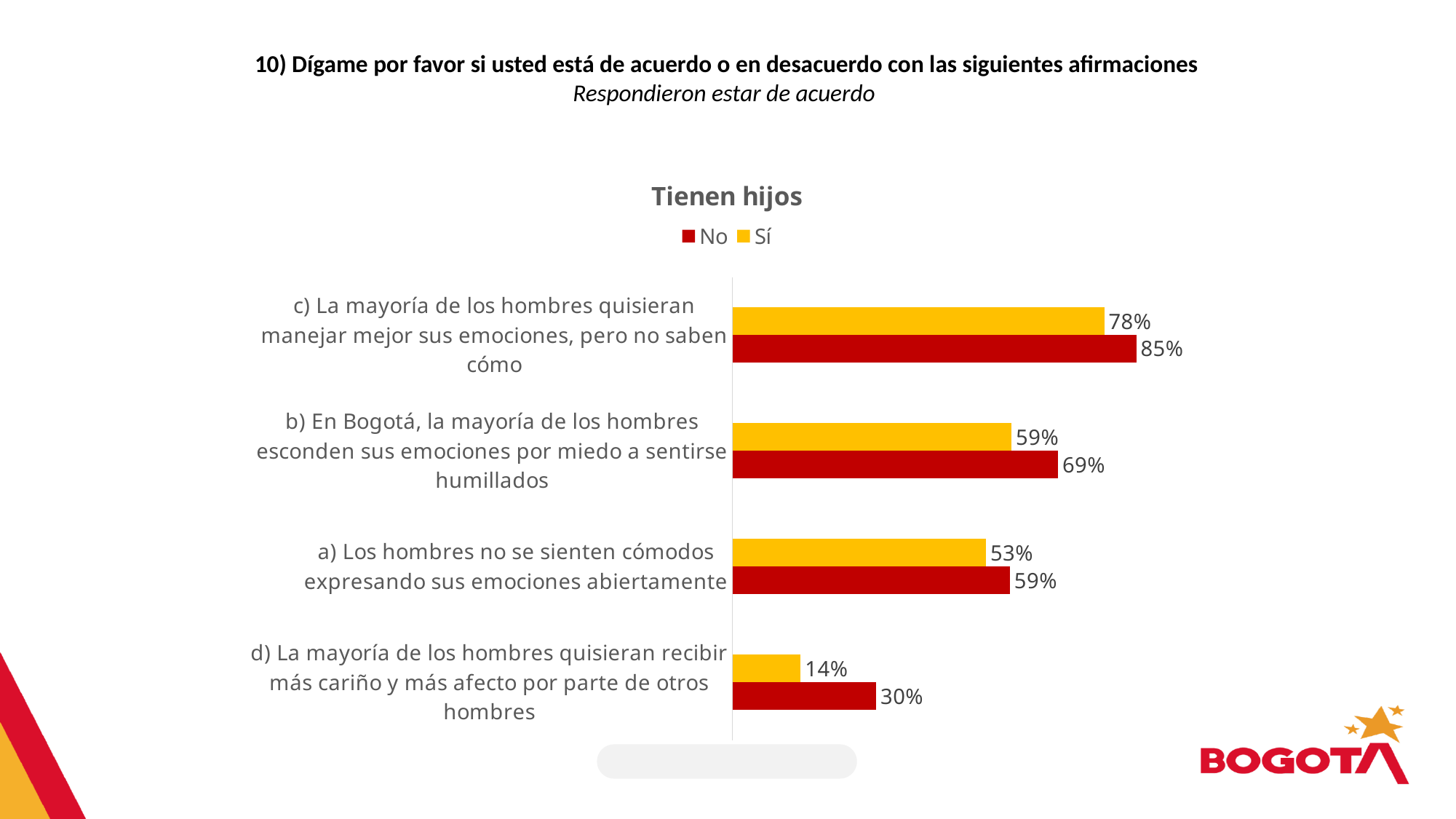
Which statement has the lowest value in the "Sí" series? d) La mayoría de los hombres quisieran recibir más cariño y más afecto por parte de otros hombres What is the value of the "No" series for statement c) La mayoría de los hombres quisieran manejar mejor sus emociones, pero no saben cómo? 85% What is the value of the "Sí" series for statement d) La mayoría de los hombres quisieran recibir más cariño y más afecto por parte de otros hombres? 14% How many series does the legend list? 2 What is the value of the "No" series for statement a) Los hombres no se sienten cómodos expresando sus emociones abiertamente? 59% What type of chart is shown on the slide? Bar chart What is the difference between the "No" and "Sí" values for statement b) En Bogotá, la mayoría de los hombres esconden sus emociones por miedo a sentirse humillados? 10% What is the value of the "Sí" series for statement b) En Bogotá, la mayoría de los hombres esconden sus emociones por miedo a sentirse humillados? 59% What is the difference between the "No" and "Sí" values for statement d) La mayoría de los hombres quisieran recibir más cariño y más afecto por parte de otros hombres? 16% For statement a) Los hombres no se sienten cómodos expresando sus emociones abiertamente, which series has the larger value, "No" or "Sí"? No How many statements (categories) are shown in the chart? 4 Which statement has the highest value in the "No" series? c) La mayoría de los hombres quisieran manejar mejor sus emociones, pero no saben cómo